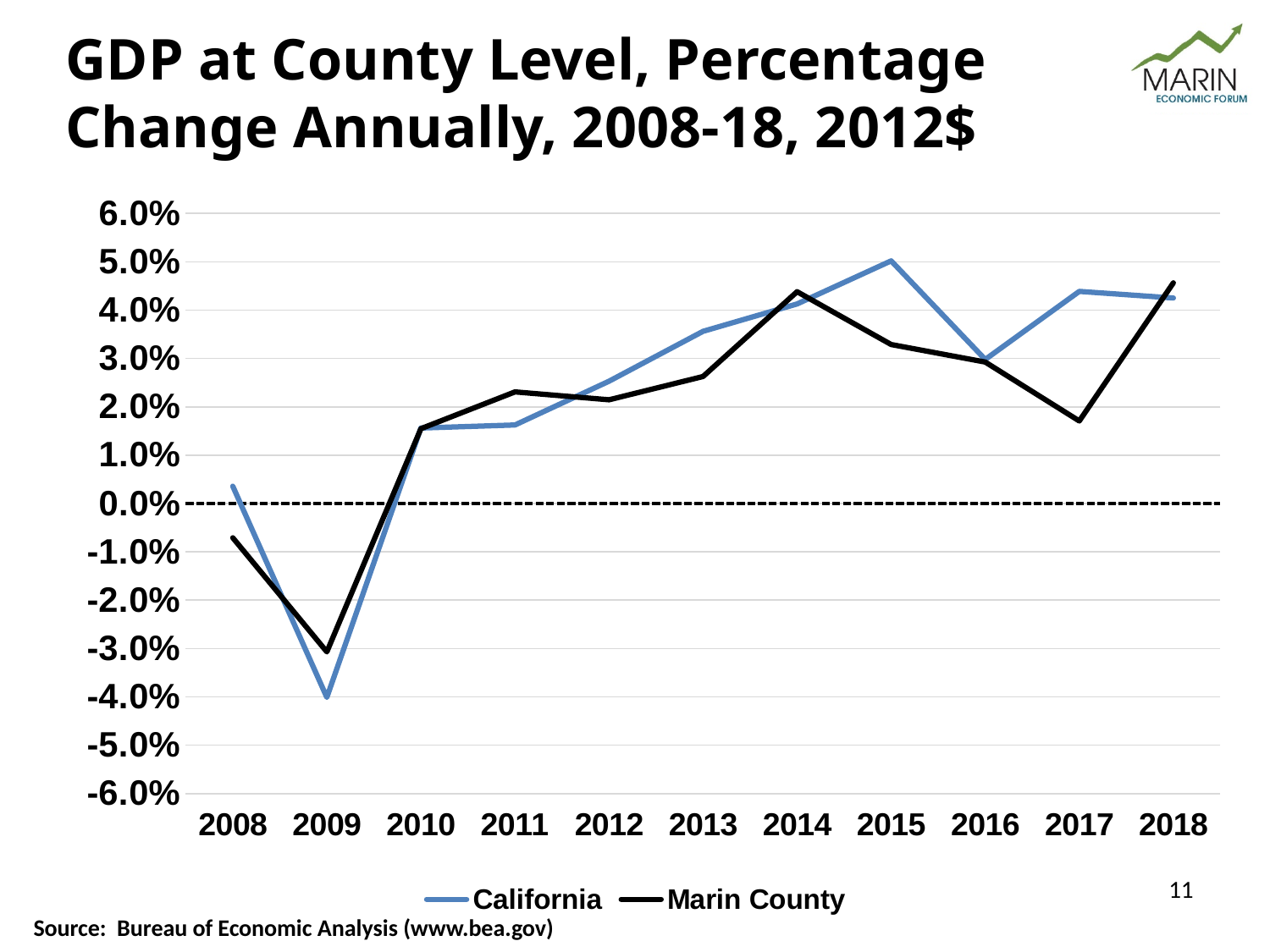
How many years are plotted along the x axis? 11 Is the value for Marin County in 2017 greater or less than 2.0%? less In 2015, which series has the higher value, California or Marin County? California How many series does the legend list? 2 What kind of chart is shown on the slide? Line chart Is the value for California in 2009 greater or less than -3.0%? less In which year is the Marin County line at its lowest? 2009 In which year is the California line at its lowest? 2009 In which year is the California line at its highest? 2015 In 2011, which series has the higher value, California or Marin County? Marin County Is the value for California in 2015 greater or less than 4.0%? greater What colour is the Marin County line? Black